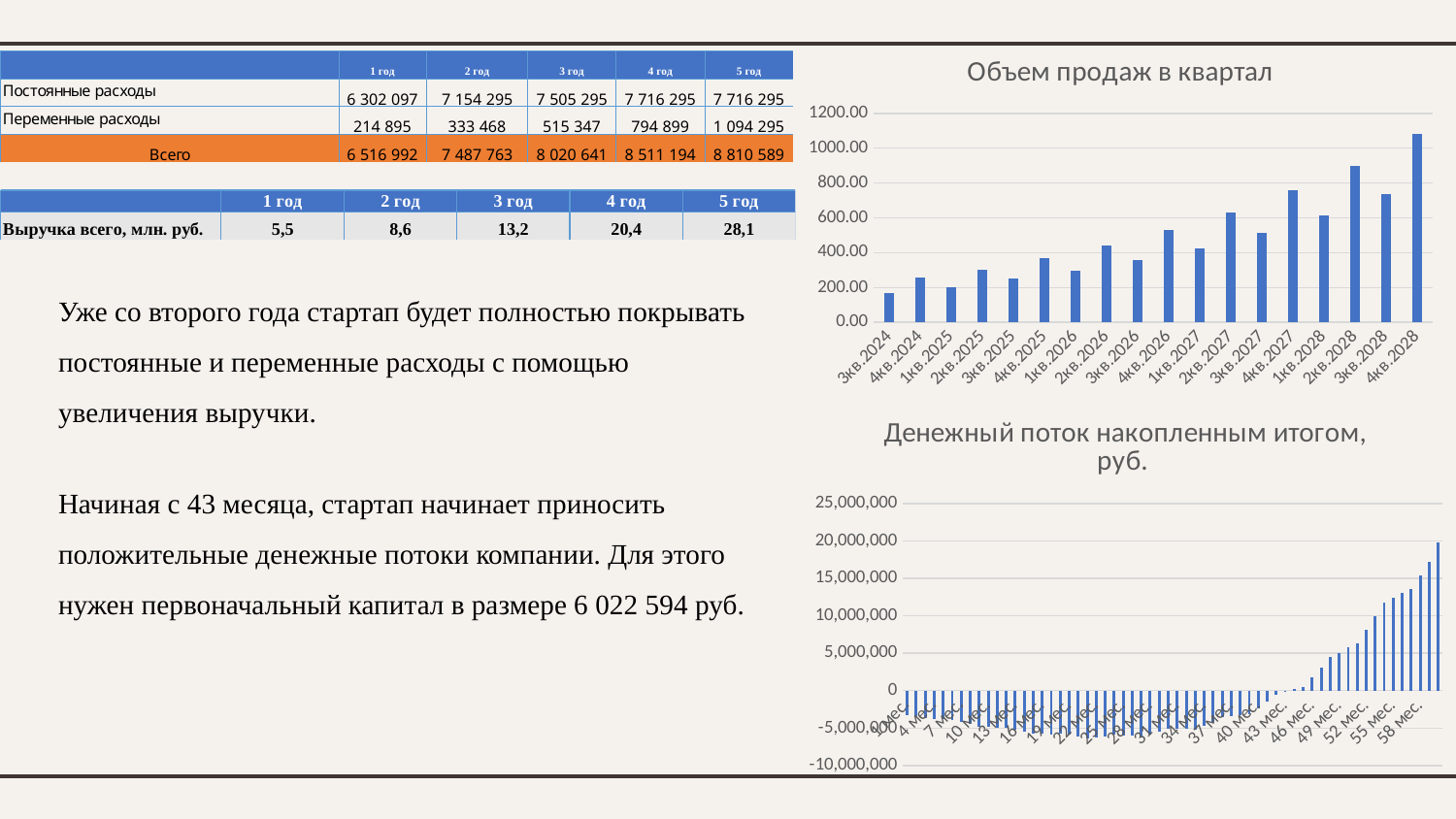
What type of chart is "Объем продаж в квартал"? bar chart What type of chart is "Денежный поток накопленным итогом, руб."? bar chart In the chart "Объем продаж в квартал", is the value for 4кв.2028 greater or less than 1000? greater In the chart "Денежный поток накопленным итогом, руб.", is the value of the last (rightmost) bar greater or less than 15,000,000? greater What is the title of the lower chart on the right side of the slide? Денежный поток накопленным итогом, руб. In the chart "Объем продаж в квартал", which quarter has the highest sales? 4кв.2028 In the chart "Объем продаж в квартал", is the value for 3кв.2024 greater or less than 200? less In the chart "Объем продаж в квартал", which quarter has the lowest sales? 3кв.2024 In the chart "Объем продаж в квартал", do the values generally rise or fall from 3кв.2024 to 4кв.2028? rise In the chart "Объем продаж в квартал", how many quarters (bars) are plotted? 18 In the chart "Объем продаж в квартал", which is larger: the value for 2кв.2028 or 3кв.2028? 2кв.2028